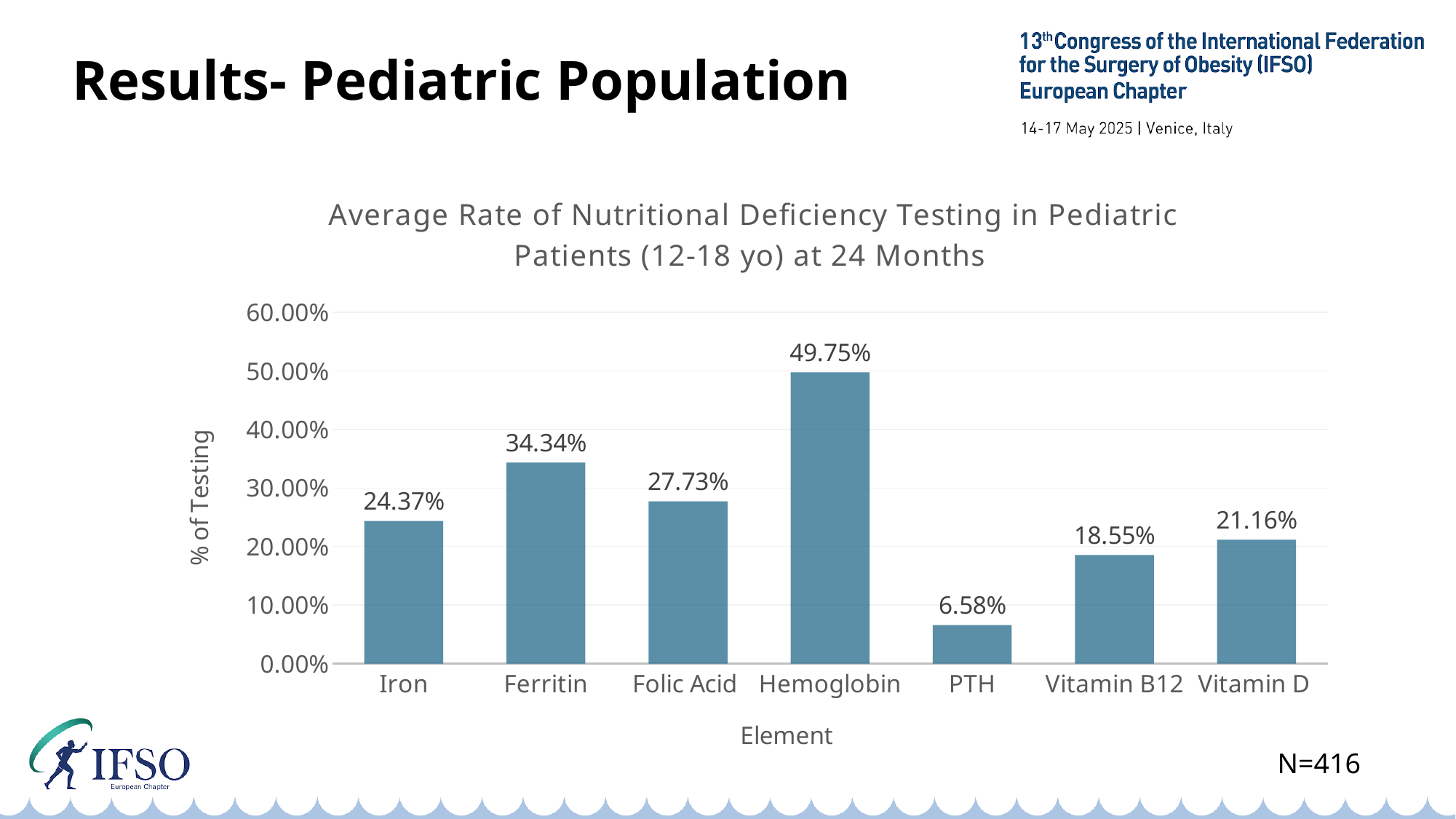
How many elements are shown on the x axis? 7 Which element has the highest rate of testing? Hemoglobin What is the title of the chart? Average Rate of Nutritional Deficiency Testing in Pediatric Patients (12-18 yo) at 24 Months What is the label of the y axis? % of Testing What is the difference between the values for Ferritin and Iron? 9.97% What is the value for PTH? 6.58% What kind of chart is shown on the slide? Bar chart Which element has the lowest rate of testing? PTH What is the value for Hemoglobin? 49.75% Which is larger, the value for Folic Acid or the value for Vitamin D? Folic Acid What is the value for Vitamin B12? 18.55% Is the value for Ferritin greater or less than 30.00%? greater